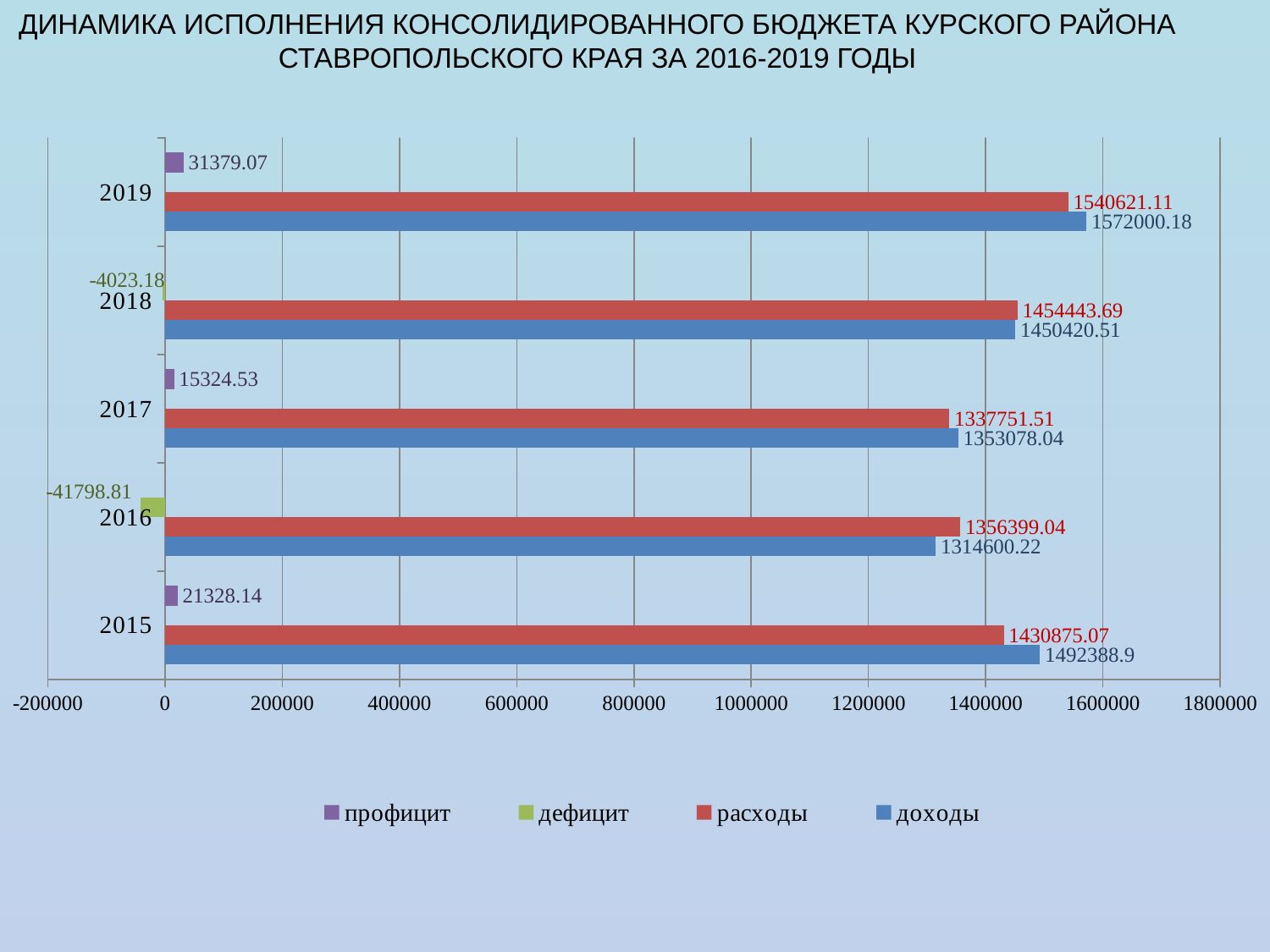
What kind of chart is shown on the slide? bar chart What is the value of дефицит for 2016? -41798.81 What is the difference between доходы and расходы in 2019? 31379.07 What is the value of доходы for 2019? 1572000.18 Is the value of расходы for 2015 greater or less than 1400000? greater In 2016, which is larger: расходы or доходы? расходы What is the value of расходы for 2017? 1337751.51 How many years are shown on the chart? 5 How many series does the legend list? 4 What is the value of профицит for 2015? 21328.14 Which year has the lowest value of доходы? 2016 Which year has the highest value of доходы? 2019